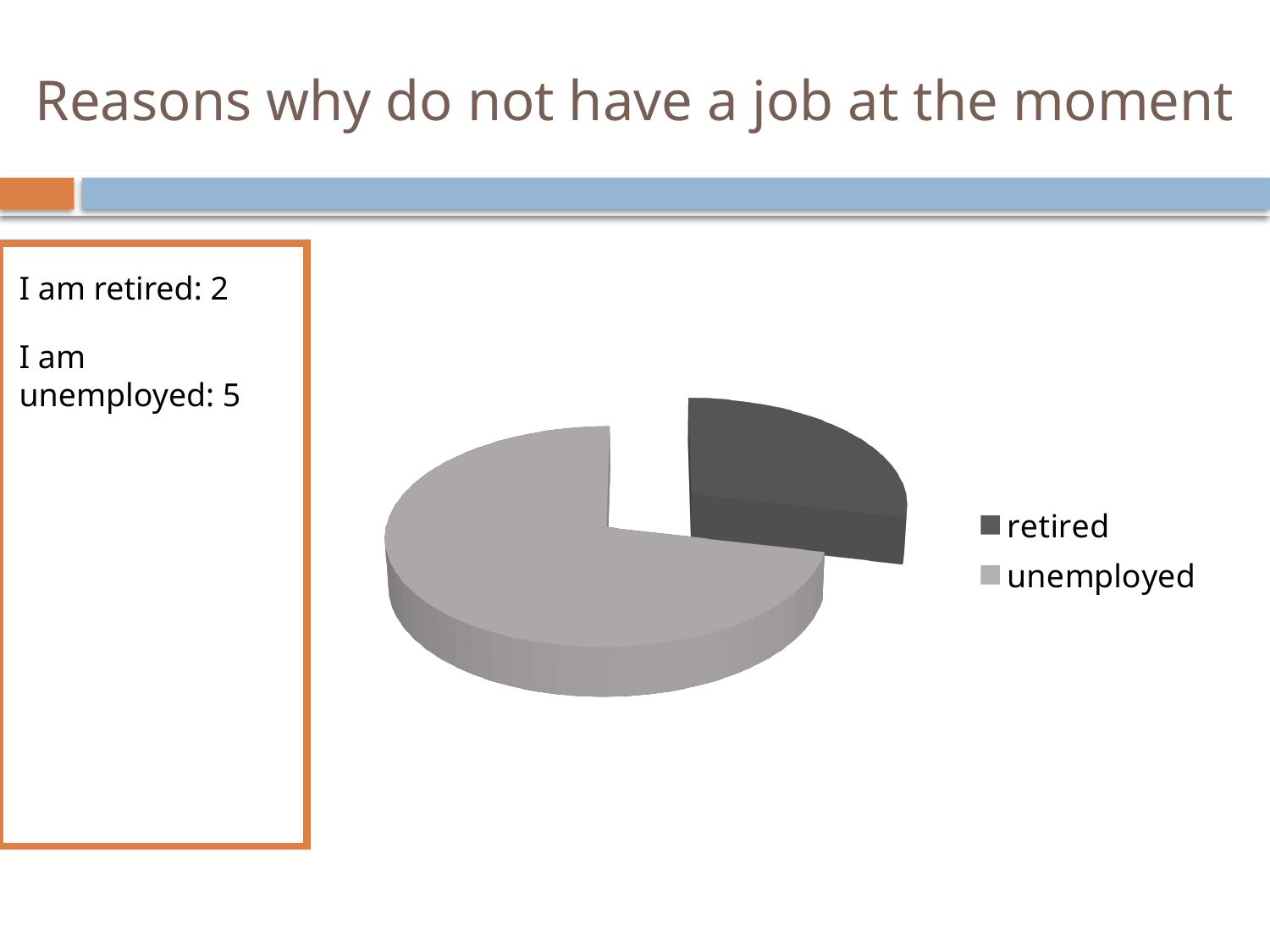
What is the value for retired? 2 What is the difference between the value for unemployed and the value for retired? 3 Which category has the smallest slice of the pie? retired Which is larger, the value for retired or the value for unemployed? unemployed What is the total of the two values shown in the pie chart? 7 What kind of chart is shown on the slide? pie chart How many entries does the legend of the pie chart list? 2 Which category has the largest slice of the pie? unemployed How many slices does the pie chart have? 2 Which legend entry is shown in the darker grey colour? retired What is the title of the slide containing the pie chart? Reasons why do not have a job at the moment What is the value for unemployed? 5